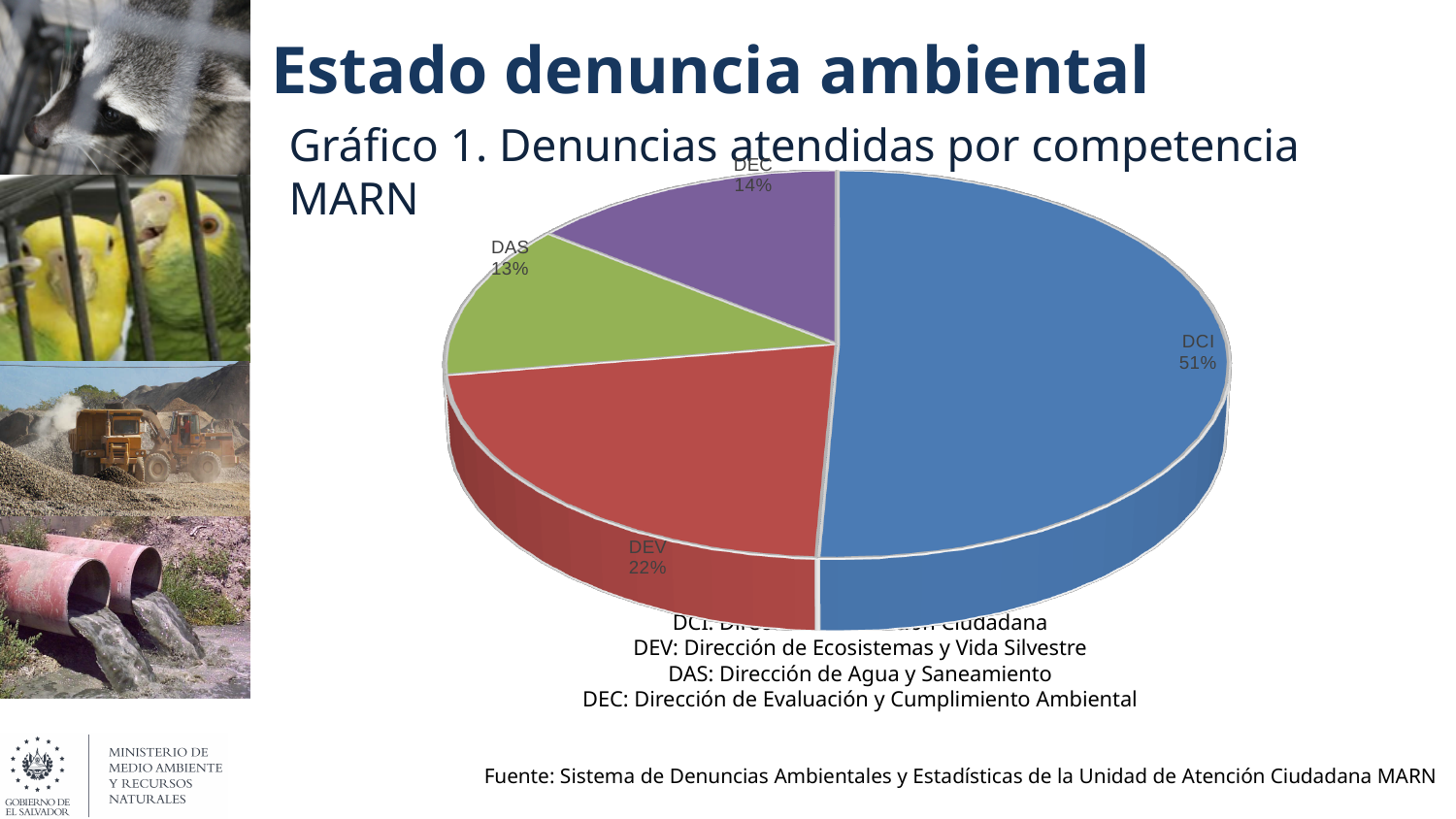
What is the difference between the DCI and DEV shares? 29% Which category has the smallest slice of the pie? DAS What colour is the DCI slice? blue What type of chart is shown on the slide? pie chart What is the value shown for DAS? 13% What share of the pie does DCI represent? 51% What share of the pie does DEV represent? 22% What is the title of the chart? Gráfico 1. Denuncias atendidas por competencia MARN Which is larger, the share for DEV or the share for DEC? DEV Which category has the largest slice of the pie? DCI How many slices does the pie chart have? 4 What is the value shown for DEC? 14%